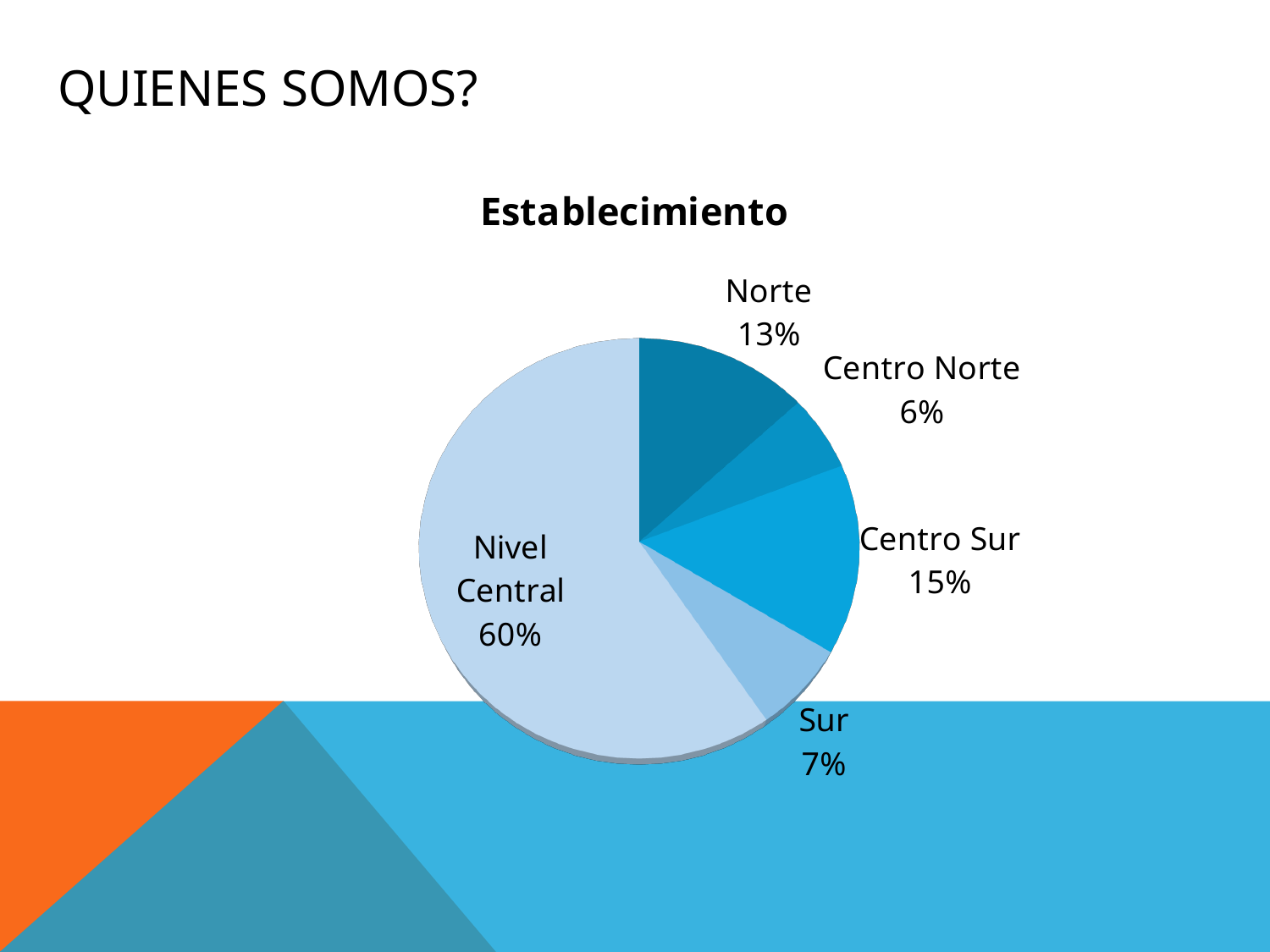
What is the value for Centro Sur? 15% What type of chart is shown on the slide? pie chart What is the value for Norte? 13% How many categories are shown in the pie chart? 5 What is the difference between the values for Centro Sur and Norte? 2% Which is larger, the value for Norte or the value for Sur? Norte What is the value for Centro Norte? 6% Which category has the smallest slice of the pie? Centro Norte What is the value for Sur? 7% What share of the pie does Nivel Central have? 60% What is the title of the chart? Establecimiento Which category has the largest slice of the pie? Nivel Central